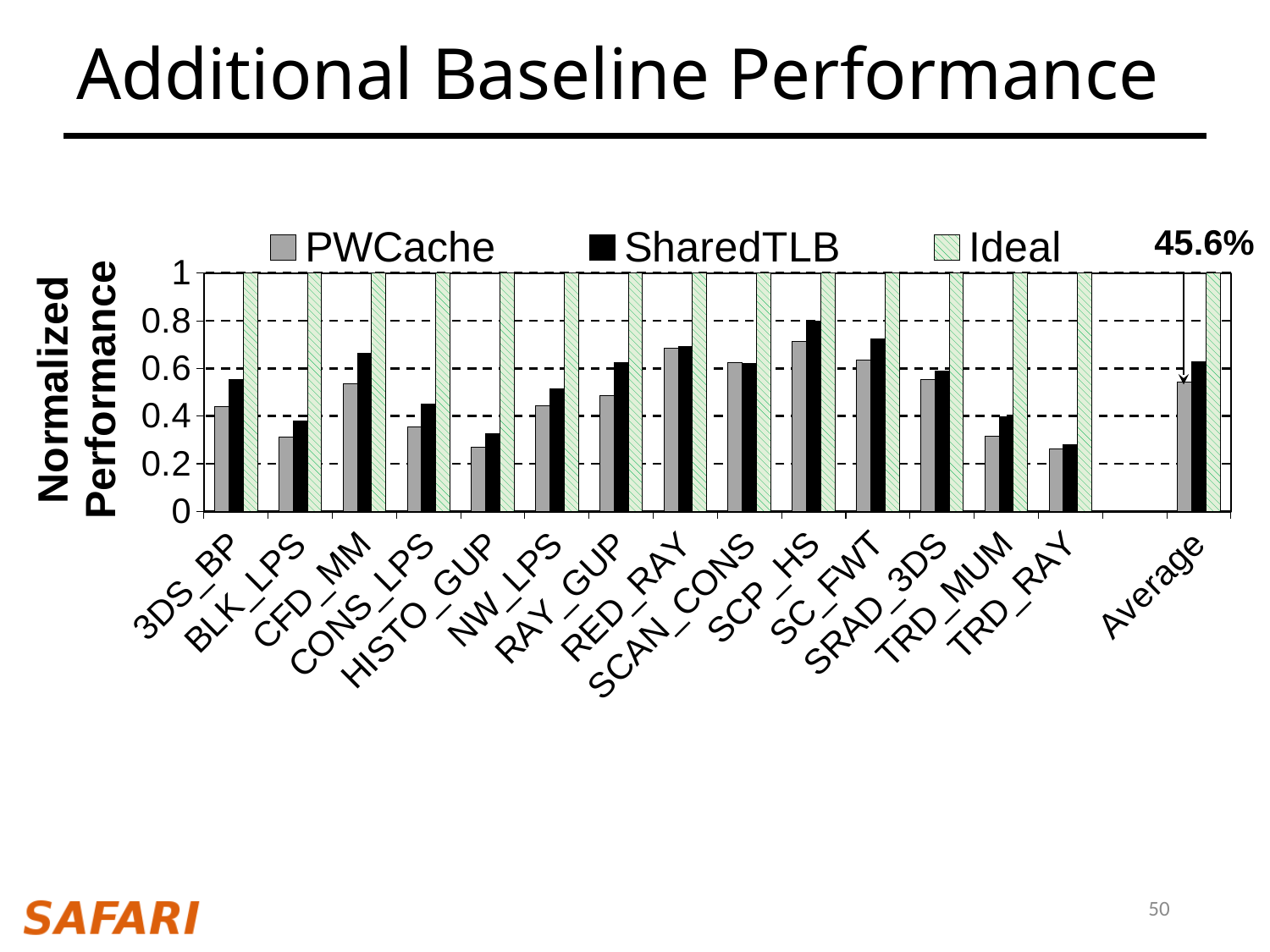
Which is larger, the SharedTLB value for SCP_HS or the SharedTLB value for TRD_RAY? SCP_HS Is the PWCache value for HISTO_GUP greater or less than 0.4? less Is the SharedTLB value for CFD_MM greater or less than 0.6? greater What kind of chart is shown on the slide? bar chart How many series does the legend list? 3 Is the PWCache value for SCP_HS greater or less than 0.6? greater How many categories are shown along the x axis, including Average? 15 Which category has the highest SharedTLB value? SCP_HS What is the Ideal value for 3DS_BP? 1 What percentage annotation is printed above the Average group? 45.6% Which is larger, the PWCache value for CFD_MM or the PWCache value for BLK_LPS? CFD_MM